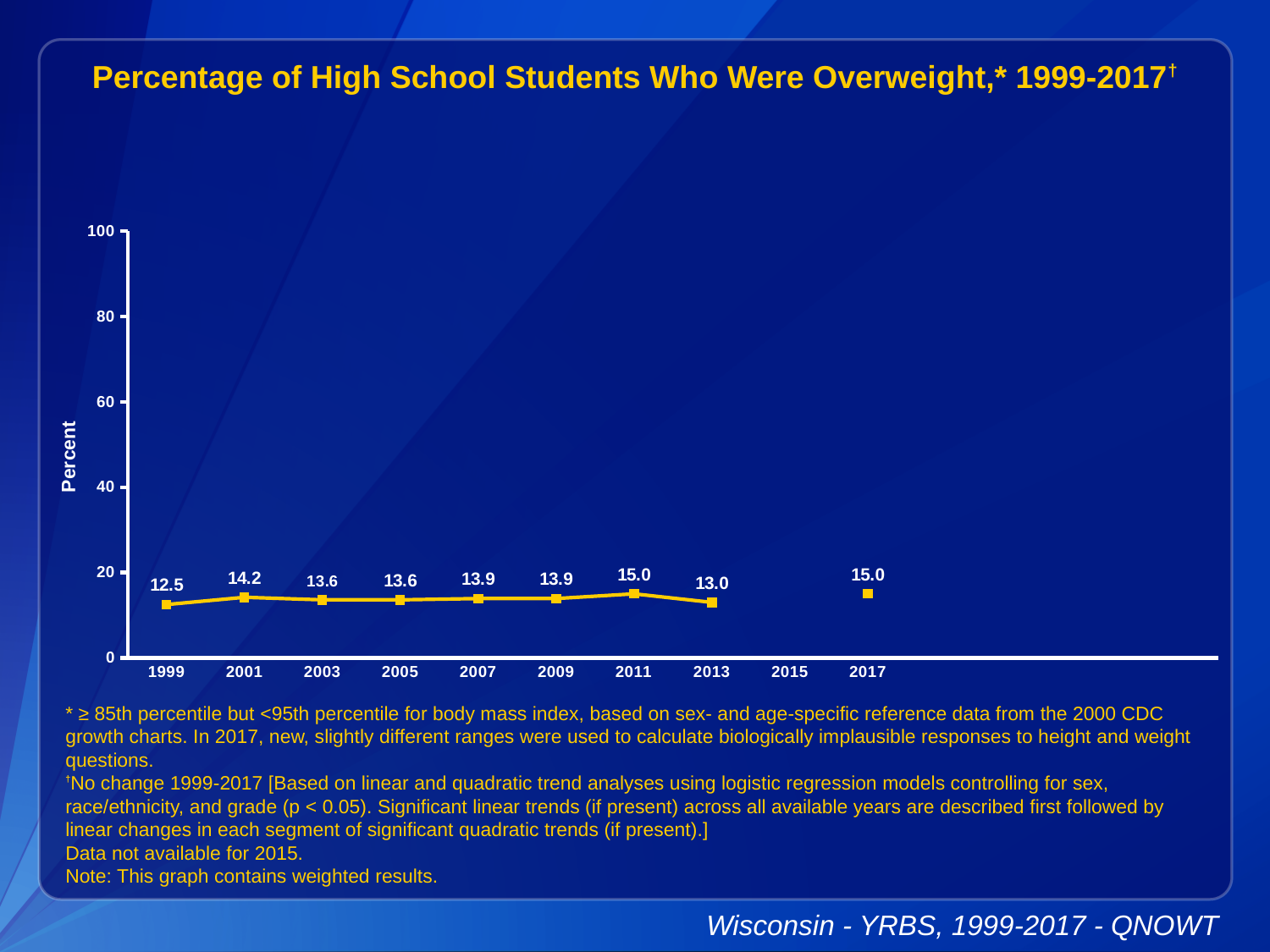
What is the value plotted for 2017? 15.0 Which is larger, the value for 2001 or the value for 2003? 2001 Is the value for 2007 greater or less than 20? less What is the value plotted for 2011? 15.0 What percentage of high school students were overweight in 1999? 12.5 What is the value plotted for 2013? 13.0 Which year has the lowest percentage of overweight students? 1999 What is the difference between the values for 2011 and 2013? 2.0 What is the label on the vertical axis of the chart? Percent How many years have a data point plotted on the chart? 9 What is the difference between the values for 2001 and 1999? 1.7 What kind of chart is shown on the slide? line chart